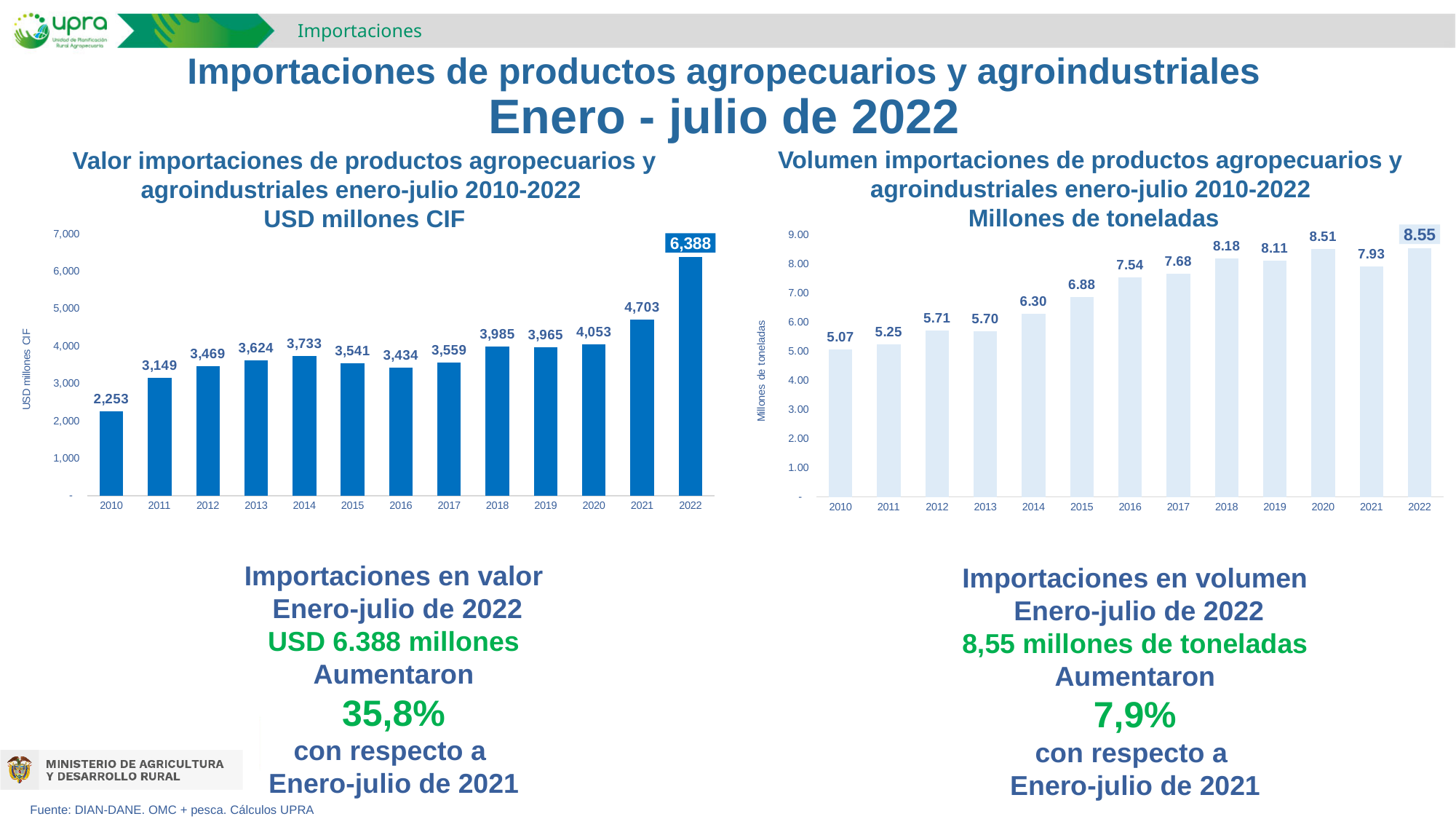
In the right chart (Volumen importaciones), what is the difference between the 2022 and 2021 values? 0.62 In the left chart (Valor importaciones), which is larger, the value for 2015 or the value for 2016? 2015 In the right chart (Volumen importaciones), which year has the highest value? 2022 What kind of chart is the right chart (Volumen importaciones)? Bar chart In the left chart (Valor importaciones), which year has the lowest value? 2010 In the left chart (Valor importaciones), what is the value for 2010? 2,253 In the right chart (Volumen importaciones), what is the value for 2020? 8.51 In the left chart (Valor importaciones), what is the difference between the 2022 and 2021 values? 1,685 In the right chart (Volumen importaciones), do the values generally rise or fall from 2010 to 2022? Rise In the left chart (Valor importaciones), what is the value for 2022? 6,388 In the left chart (Valor importaciones), how many years are plotted? 13 In the right chart (Volumen importaciones), which is larger, the value for 2018 or the value for 2019? 2018